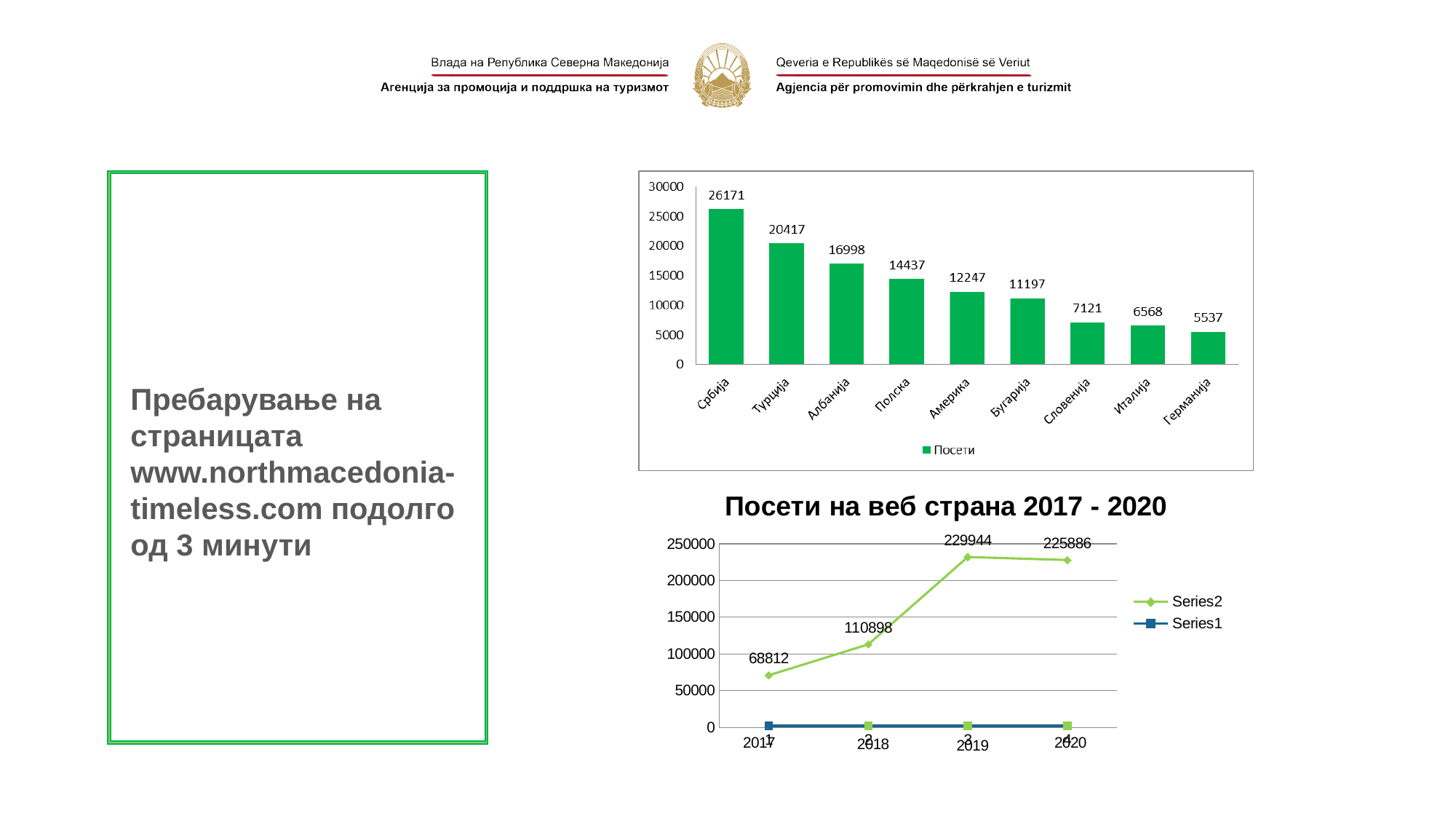
In the top bar chart, what is the value for Србија? 26171 What type of chart is the top chart on the slide? bar chart In the top bar chart, what is the difference between the values for Турција and Албанија? 3419 In the top bar chart, which category has the highest value? Србија In the chart titled 'Посети на веб страна 2017 - 2020', what is the Series2 value for 2019? 229944 How many categories are shown in the top bar chart? 9 In the top bar chart, which category has the lowest value? Германија In the chart titled 'Посети на веб страна 2017 - 2020', what is the difference between the Series2 values for 2018 and 2017? 42086 In the top bar chart, what is the value for Бугарија? 11197 How many series does the legend list in the chart titled 'Посети на веб страна 2017 - 2020'? 2 In the top bar chart, which is larger, the value for Полска or the value for Америка? Полска In the chart titled 'Посети на веб страна 2017 - 2020', does Series2 rise or fall from 2017 to 2019? rise